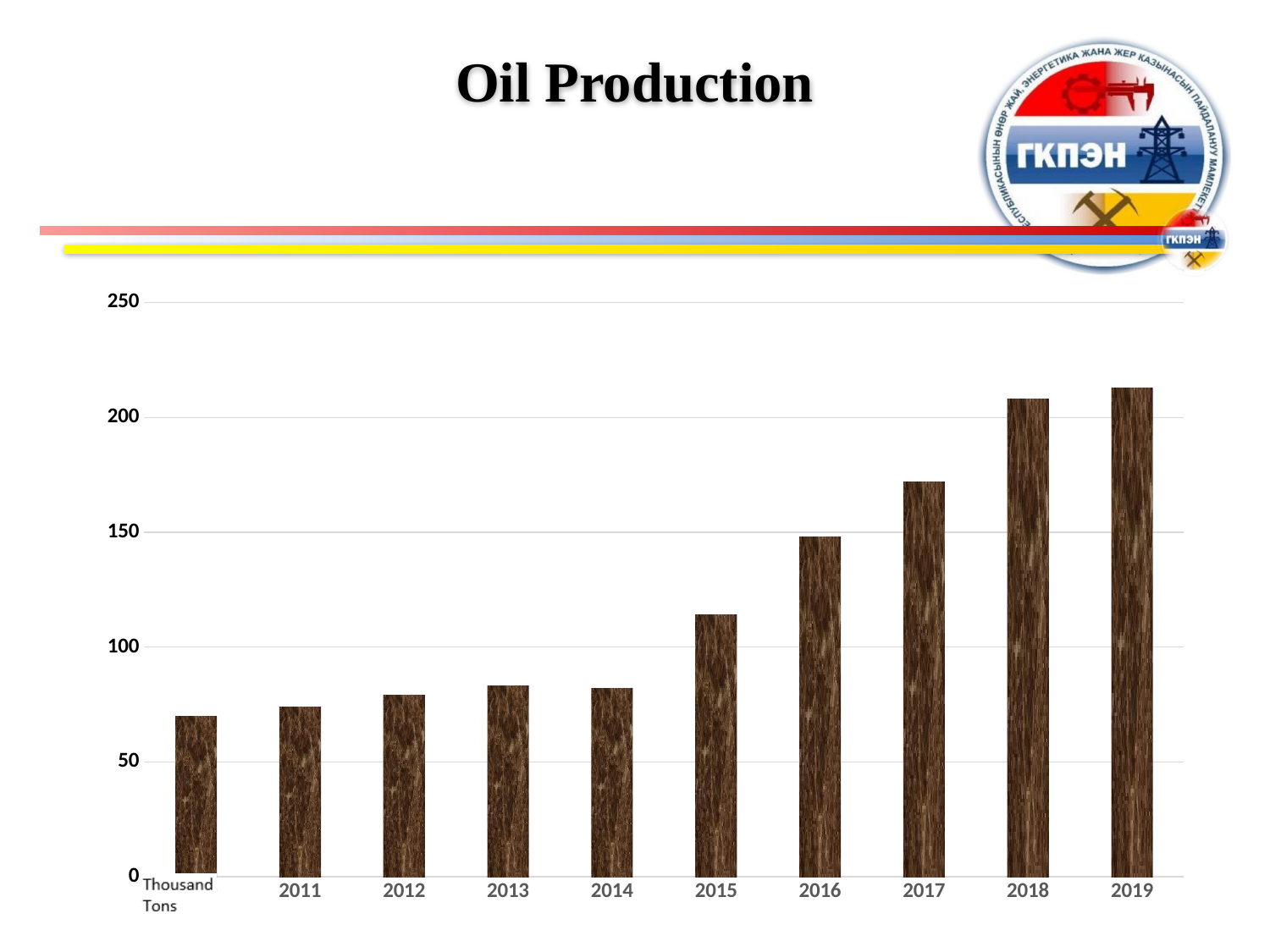
Is the value for 2012 greater or less than 100? less In what units is oil production measured on the chart? Thousand Tons Which year has the larger value, 2014 or 2015? 2015 Do the values generally rise or fall from 2011 to 2019? rise Is the value for 2018 greater or less than 200? greater What kind of chart is shown on the slide? bar chart Is the value for 2015 greater or less than 100? greater Which year has the larger value, 2016 or 2017? 2017 What is the title of the chart? Oil Production How many bars are plotted on the chart? 10